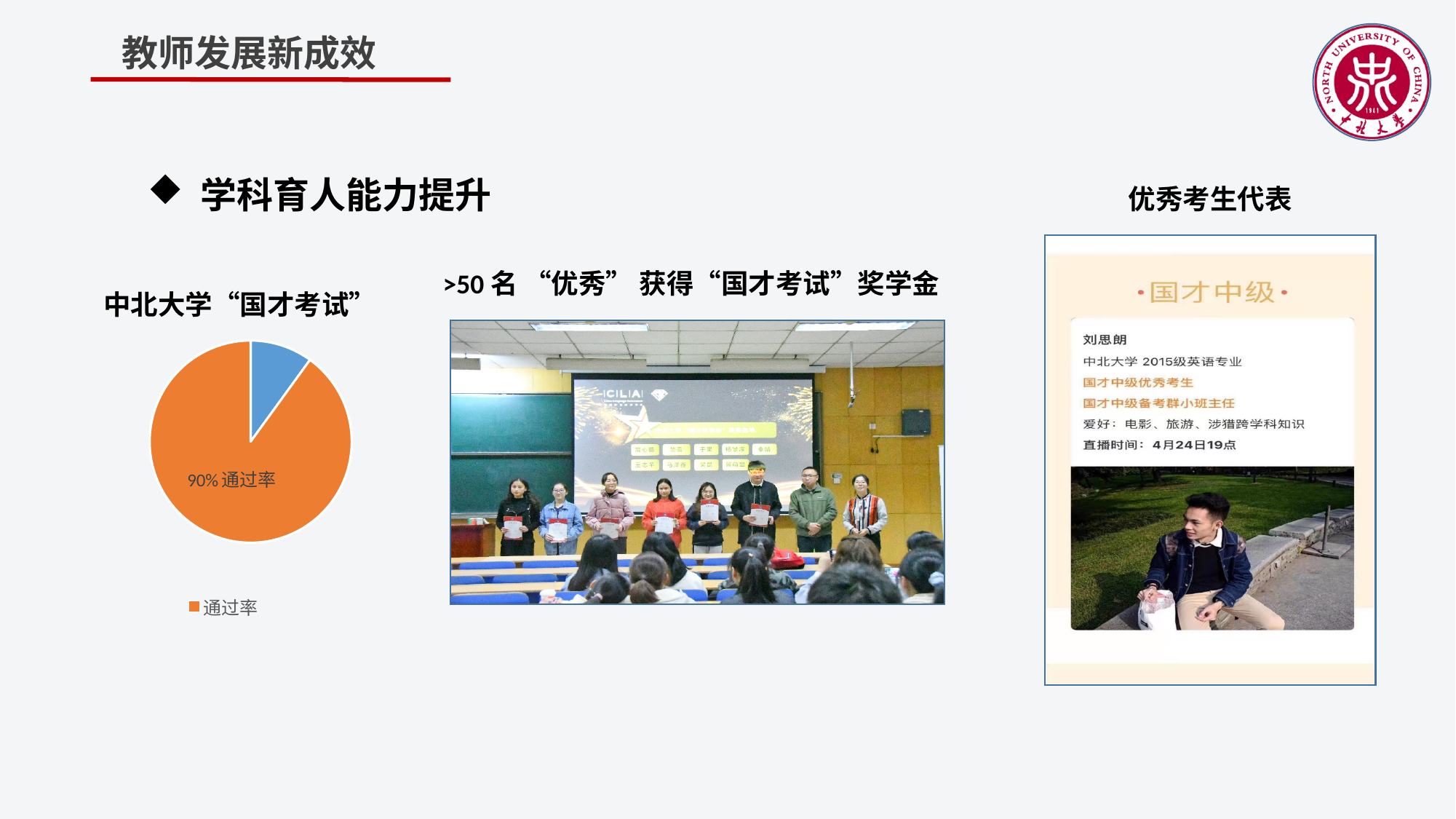
What kind of chart is shown on the left of the slide? pie chart What share of the pie chart does the 通过率 slice take up? 90% In the pie chart, which slice is larger, the orange one or the blue one? the orange one How many slices does the pie chart have? 2 How many entries does the legend of the pie chart list? 1 What is the title of the pie chart on the left of the slide? 中北大学“国才考试” In the pie chart, what value is printed on the orange slice? 90% 通过率 Which slice of the pie chart is the largest? 通过率 What is the legend entry shown below the pie chart? 通过率